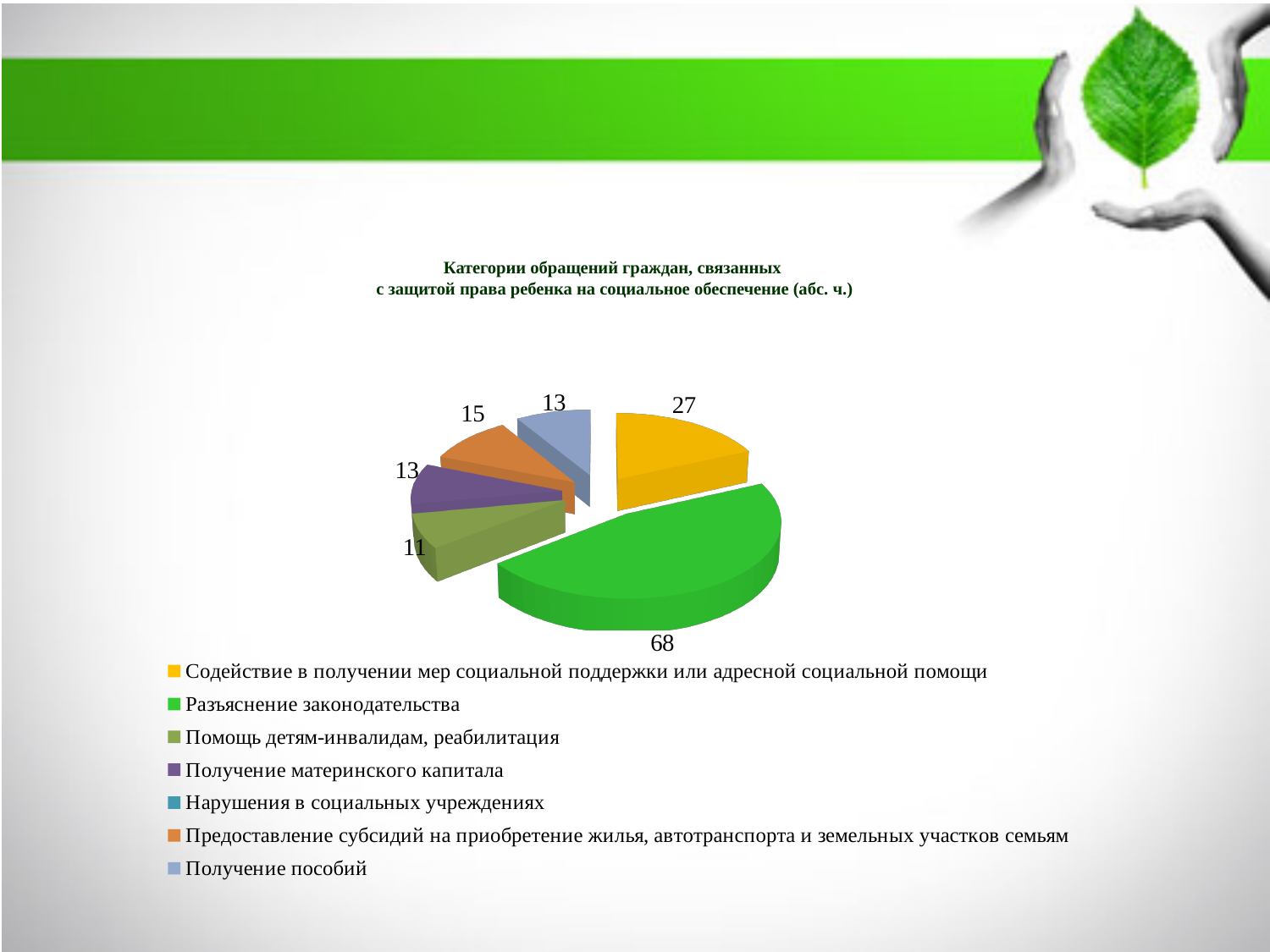
Which category has the largest slice of the pie? Разъяснение законодательства What value is shown for 'Содействие в получении мер социальной поддержки или адресной социальной помощи'? 27 What is the difference between the values for 'Предоставление субсидий на приобретение жилья, автотранспорта и земельных участков семьям' and 'Помощь детям-инвалидам, реабилитация'? 4 What value is shown for 'Получение пособий'? 13 What is the difference between the values for 'Разъяснение законодательства' and 'Содействие в получении мер социальной поддержки или адресной социальной помощи'? 41 What value is shown for 'Предоставление субсидий на приобретение жилья, автотранспорта и земельных участков семьям'? 15 What value is shown for 'Помощь детям-инвалидам, реабилитация'? 11 What kind of chart is shown on the slide? Pie chart How many categories does the legend list? 7 What value is shown for the slice 'Разъяснение законодательства'? 68 What value is shown for 'Получение материнского капитала'? 13 Which is larger: the value for 'Содействие в получении мер социальной поддержки или адресной социальной помощи' or for 'Предоставление субсидий на приобретение жилья, автотранспорта и земельных участков семьям'? Содействие в получении мер социальной поддержки или адресной социальной помощи